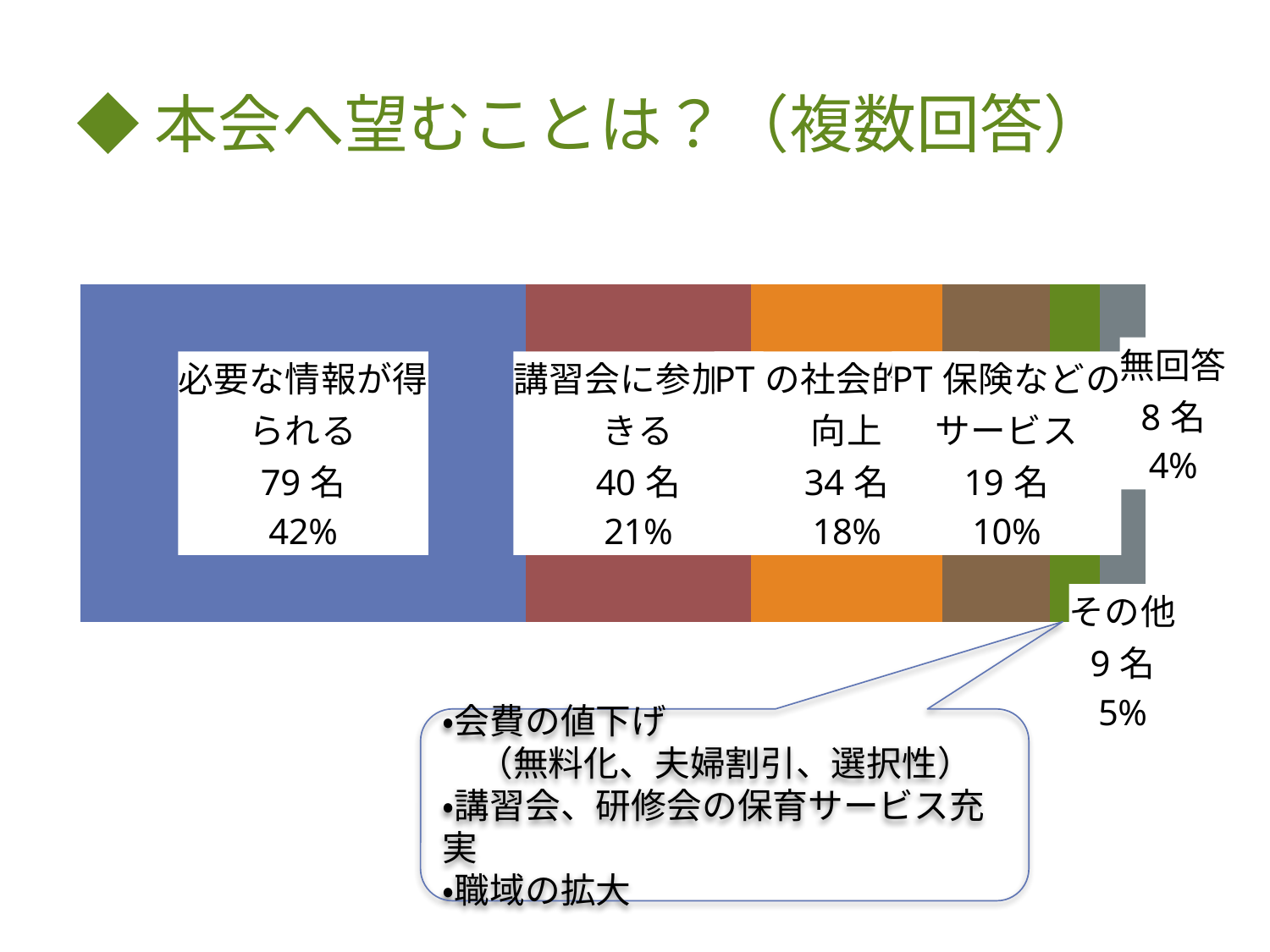
What is the total number of respondents across all segments of the bar? 189名 What percentage is shown for 無回答? 4% How many respondents are in the その他 segment? 9名 How many segments (response categories) does the stacked bar contain? 6 What is the difference in respondents between 必要な情報が得られる and 講習会に参加できる? 39名 How many respondents chose PTの社会的向上? 34名 What kind of chart is shown on the slide? Stacked bar chart Which category has the largest number of respondents? 必要な情報が得られる Which category has the smallest number of respondents? 無回答 What percentage is shown for PT保険などのサービス? 10% How many respondents chose 必要な情報が得られる? 79名 What percentage is shown for 講習会に参加できる? 21%